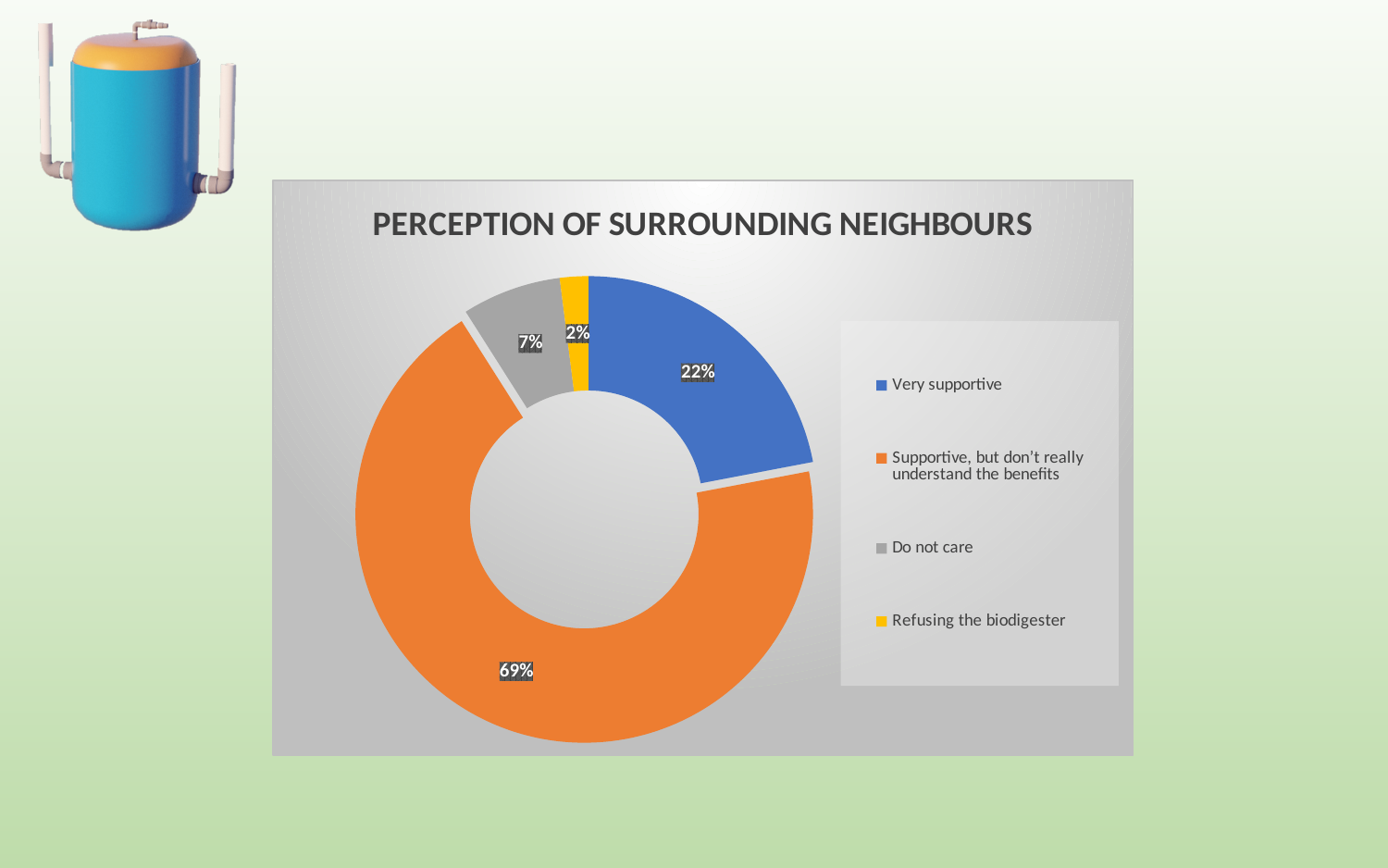
Which category has the smallest share? Refusing the biodigester What kind of chart is shown on the slide? Doughnut (pie) chart What share of neighbours 'Do not care'? 7% How many categories does the legend list? 4 What is the difference between the 'Supportive, but don't really understand the benefits' share and the 'Very supportive' share? 47% What is the title of the chart? PERCEPTION OF SURROUNDING NEIGHBOURS What colour represents 'Very supportive' in the chart? Blue What share of neighbours are 'Refusing the biodigester'? 2% What share of neighbours are 'Supportive, but don't really understand the benefits'? 69% Which is larger: the 'Do not care' share or the 'Refusing the biodigester' share? Do not care What share of neighbours are 'Very supportive'? 22% Which category has the largest share? Supportive, but don't really understand the benefits